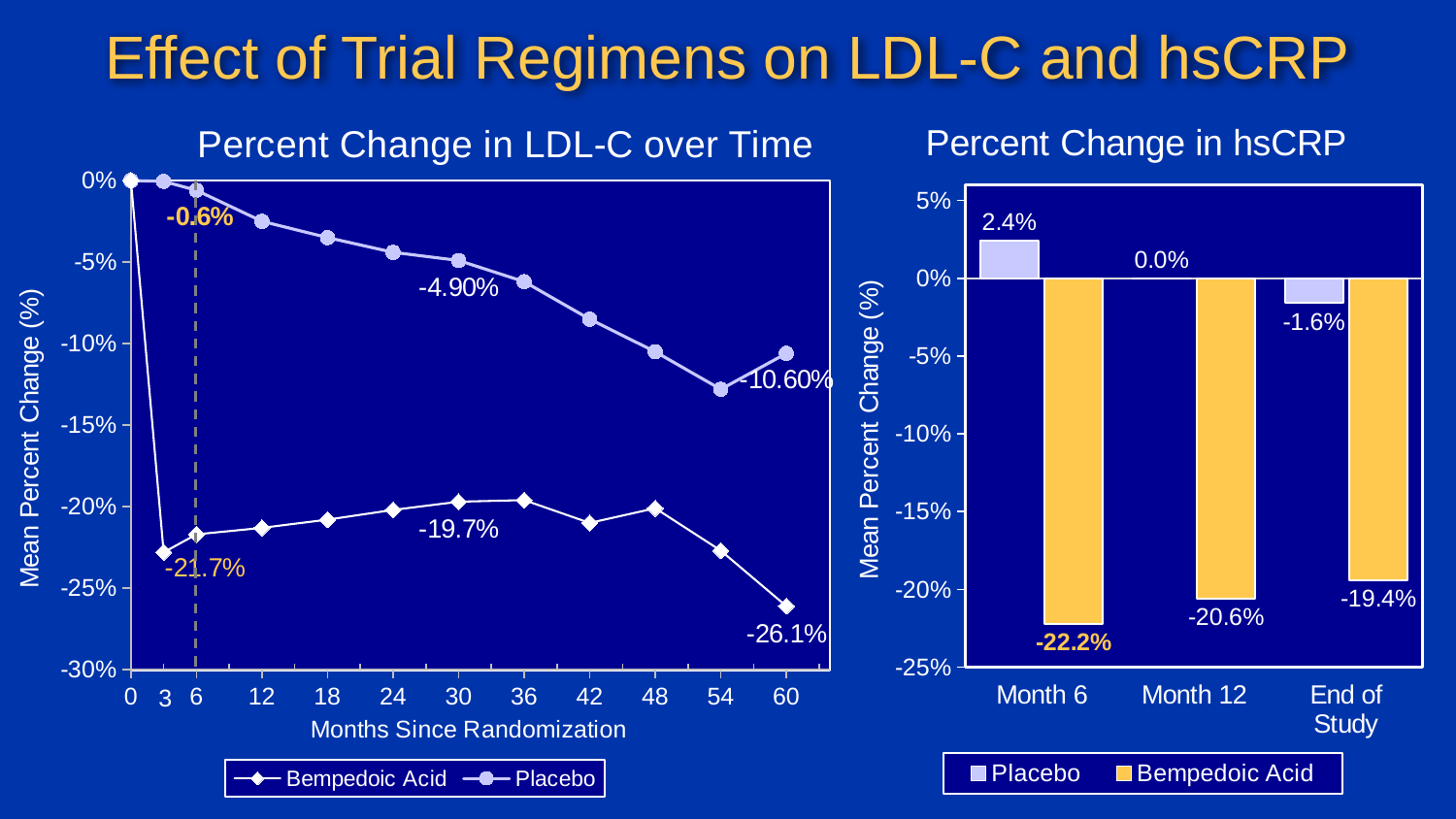
How many categories are shown on the x axis of the Percent Change in hsCRP chart? 3 In the Percent Change in hsCRP chart, what is the value for Placebo at Month 6? 2.4% In the Percent Change in hsCRP chart, what is the difference between the Placebo and Bempedoic Acid values at Month 12? 20.6 percentage points How many series does the legend of the Percent Change in LDL-C over Time chart list? 2 In the Percent Change in LDL-C over Time chart, does the Placebo line generally rise or fall from month 0 to month 60? Fall In the Percent Change in hsCRP chart, what is the value for Bempedoic Acid at Month 6? -22.2% What kind of chart is the Percent Change in hsCRP chart? Bar chart In the Percent Change in LDL-C over Time chart, what is the labelled value for Placebo at month 30? -4.90% In the Percent Change in LDL-C over Time chart, is the Bempedoic Acid value at month 3 greater or less than -20%? less In the Percent Change in LDL-C over Time chart, which series shows the larger decrease at month 60? Bempedoic Acid In the Percent Change in hsCRP chart, which category has the lowest Bempedoic Acid value? Month 6 In the Percent Change in LDL-C over Time chart, what is the labelled value for Bempedoic Acid at month 60? -26.1%